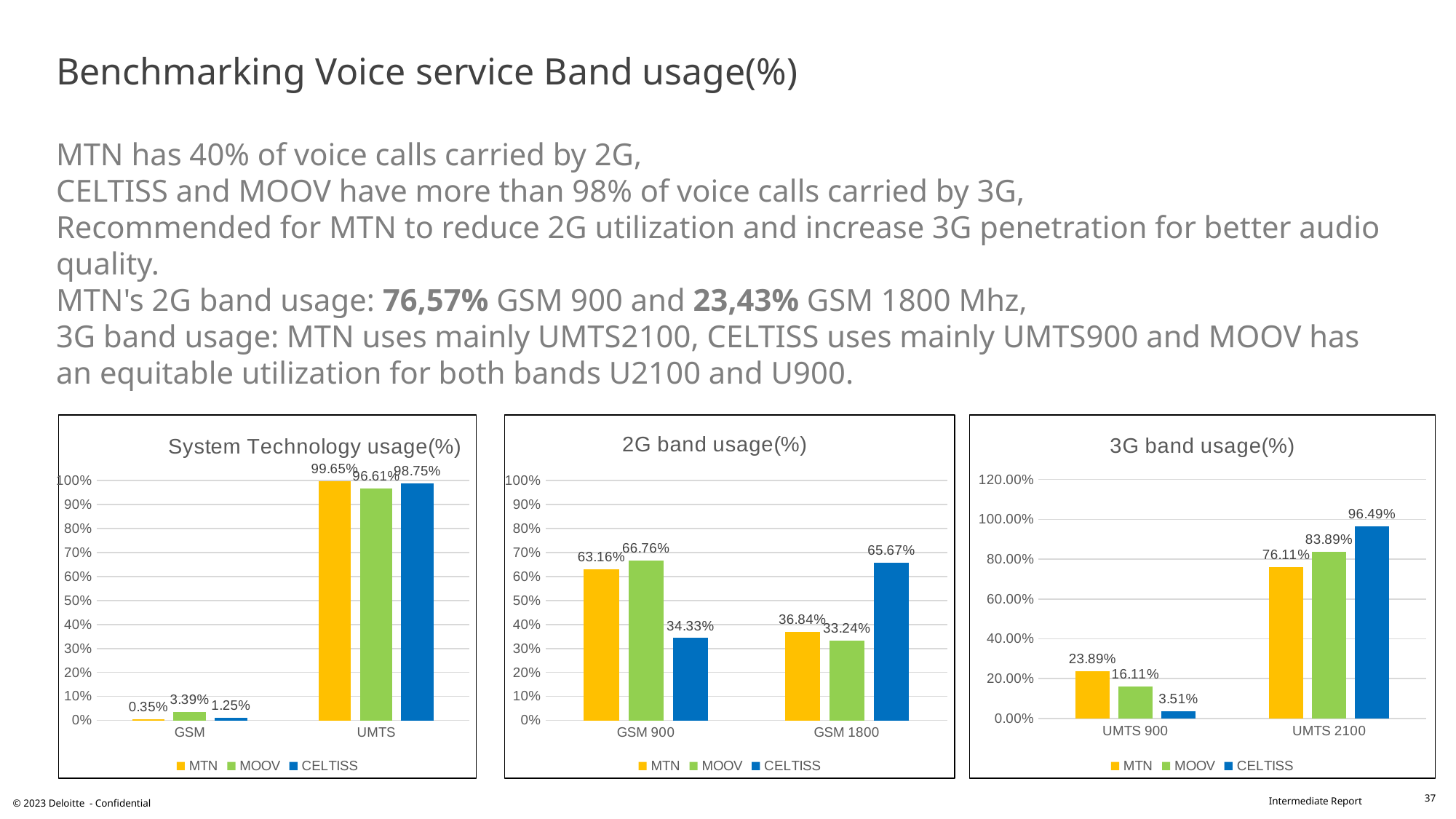
In the "3G band usage(%)" chart, what is the value for MOOV in the UMTS 2100 category? 83.89% In the "3G band usage(%)" chart, is the value for MTN in UMTS 900 larger or smaller than the value for CELTISS in UMTS 900? larger In the "2G band usage(%)" chart, what is the value for CELTISS in the GSM 1800 category? 65.67% In the "System Technology usage(%)" chart, which series has the highest value in the GSM category? MOOV In the "2G band usage(%)" chart, what is the difference between the MOOV and MTN values for GSM 900? 3.60% In the "2G band usage(%)" chart, which series has the lowest value in the GSM 900 category? CELTISS How many categories are shown on the x axis of the "3G band usage(%)" chart? 2 In the "3G band usage(%)" chart, which series has the highest value in the UMTS 2100 category? CELTISS In the "System Technology usage(%)" chart, what is the value for MTN in the UMTS category? 99.65% In the "3G band usage(%)" chart, what is the difference between the CELTISS and MTN values for UMTS 2100? 20.38% What kind of chart is the "System Technology usage(%)" chart? Bar chart How many series does the legend of the "2G band usage(%)" chart list? 3